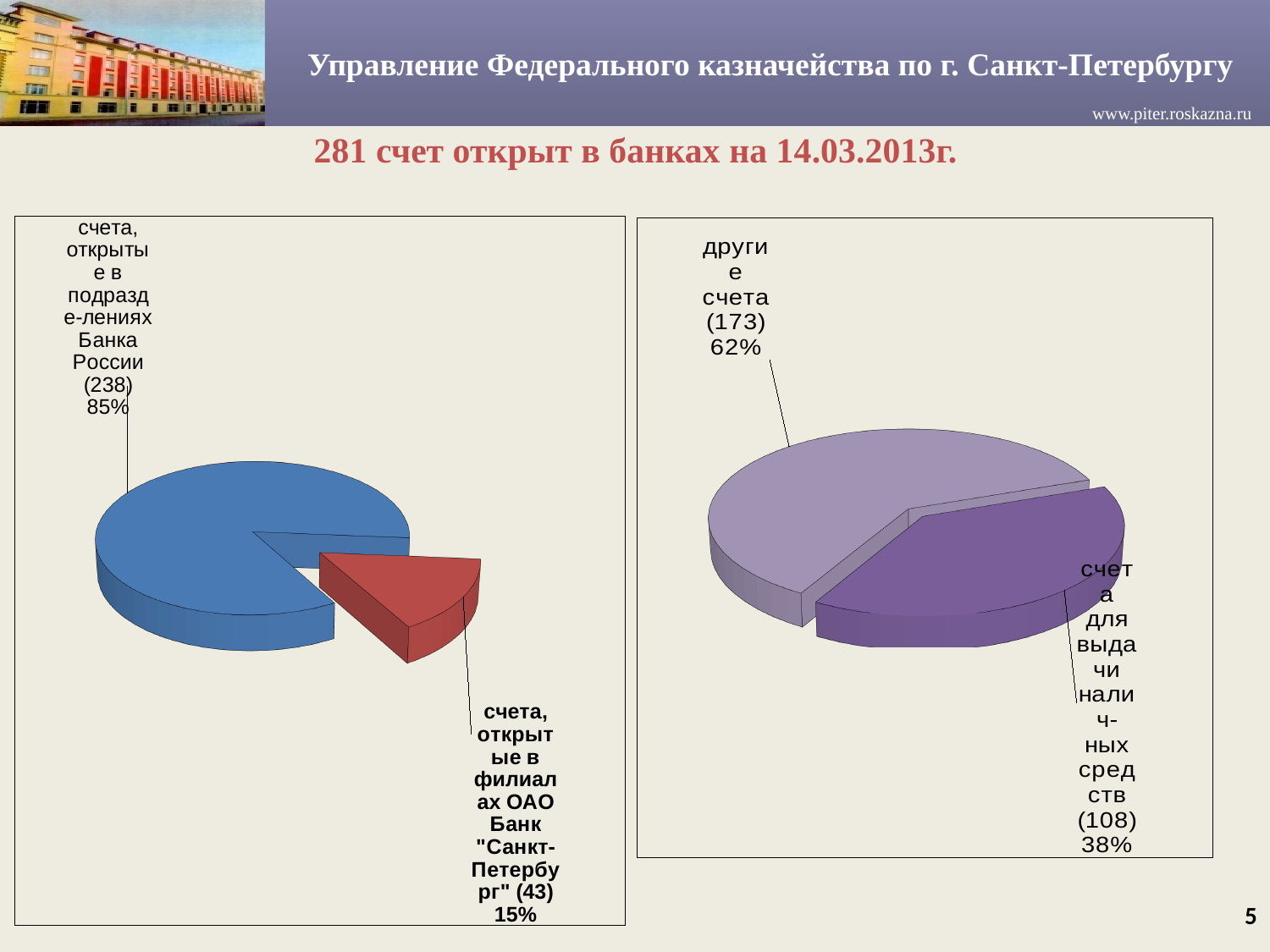
In the right pie chart, what is the difference in the number of accounts between "другие счета" (173) and "счета для выдачи наличных средств" (108)? 65 In the left pie chart, what percentage share is shown for accounts opened in divisions of the Bank of Russia ("счета, открытые в подразделениях Банка России")? 85% How many slices does the left pie chart have? 2 What type of chart is the right chart on the slide? Pie chart In the right pie chart, what percentage share is shown for "другие счета"? 62% In the left pie chart, how many accounts are shown for "счета, открытые в филиалах ОАО Банк "Санкт-Петербург""? 43 In the right pie chart, which category has the smallest slice? счета для выдачи наличных средств What is the total number of accounts stated in the slide title? 281 In the right pie chart, how many accounts are shown for "счета для выдачи наличных средств"? 108 In the left pie chart, what is the difference in the number of accounts between the Bank of Russia divisions slice (238) and the OAO Bank "Санкт-Петербург" branches slice (43)? 195 In the left pie chart, which category has the largest slice? счета, открытые в подразделениях Банка России In the right pie chart, which is larger: "другие счета" or "счета для выдачи наличных средств"? другие счета